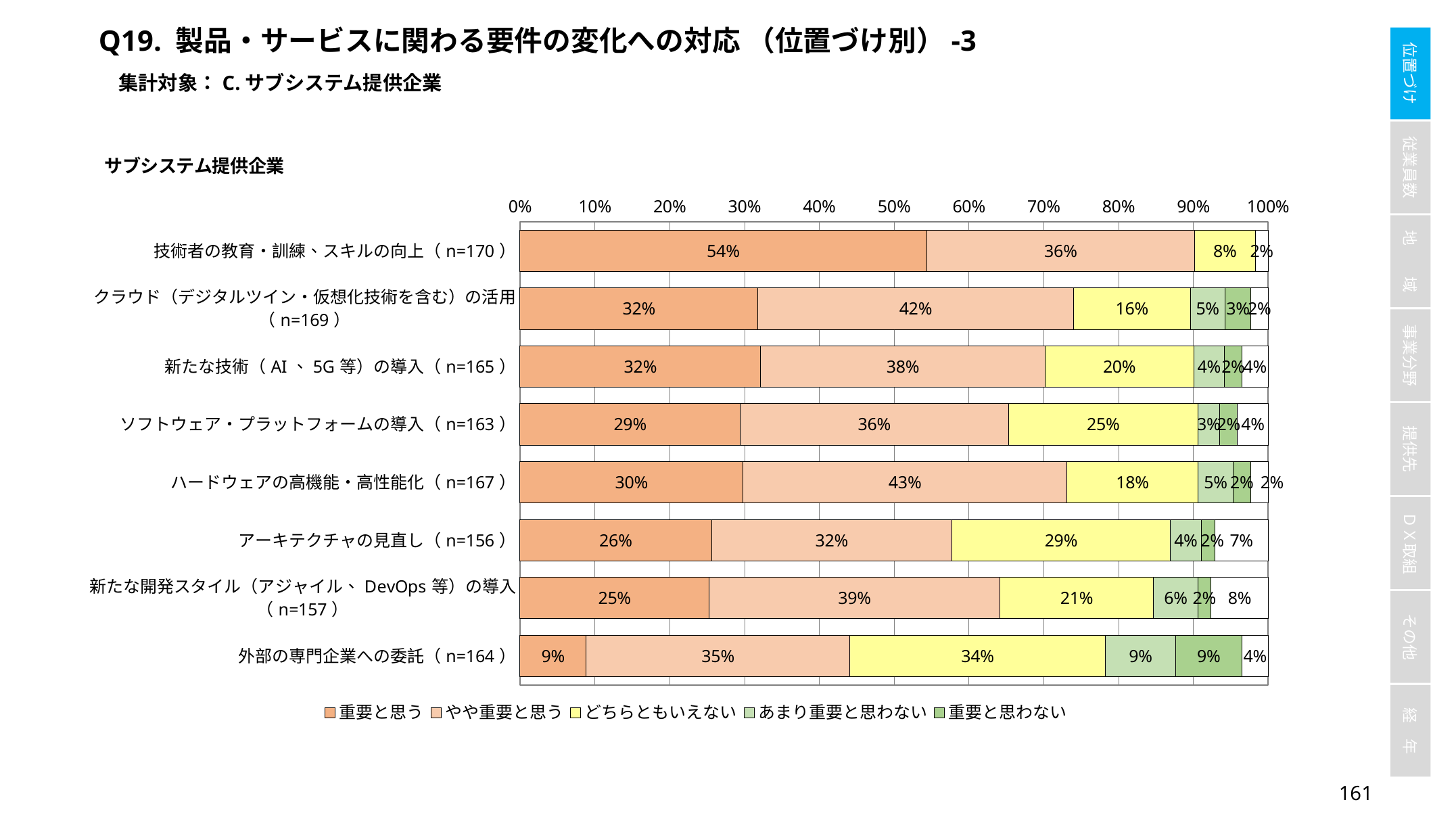
What is the value of どちらともいえない for 外部の専門企業への委託? 34% What is the difference in 重要と思う between 技術者の教育・訓練、スキルの向上 and クラウド（デジタルツイン・仮想化技術を含む）の活用? 22 percentage points What is the value of 重要と思う for 技術者の教育・訓練、スキルの向上? 54% Which category has the lowest value for 重要と思う? 外部の専門企業への委託 What is the value of やや重要と思う for ハードウェアの高機能・高性能化? 43% What is the first entry listed in the legend? 重要と思う Which category has the highest value for 重要と思う? 技術者の教育・訓練、スキルの向上 Which has the larger value for どちらともいえない: アーキテクチャの見直し or ソフトウェア・プラットフォームの導入? アーキテクチャの見直し How many series does the legend list? 5 What kind of chart is shown on the slide? Stacked bar chart What is the combined share of 重要と思う and やや重要と思う for 技術者の教育・訓練、スキルの向上? 90% How many categories are shown in the chart? 8